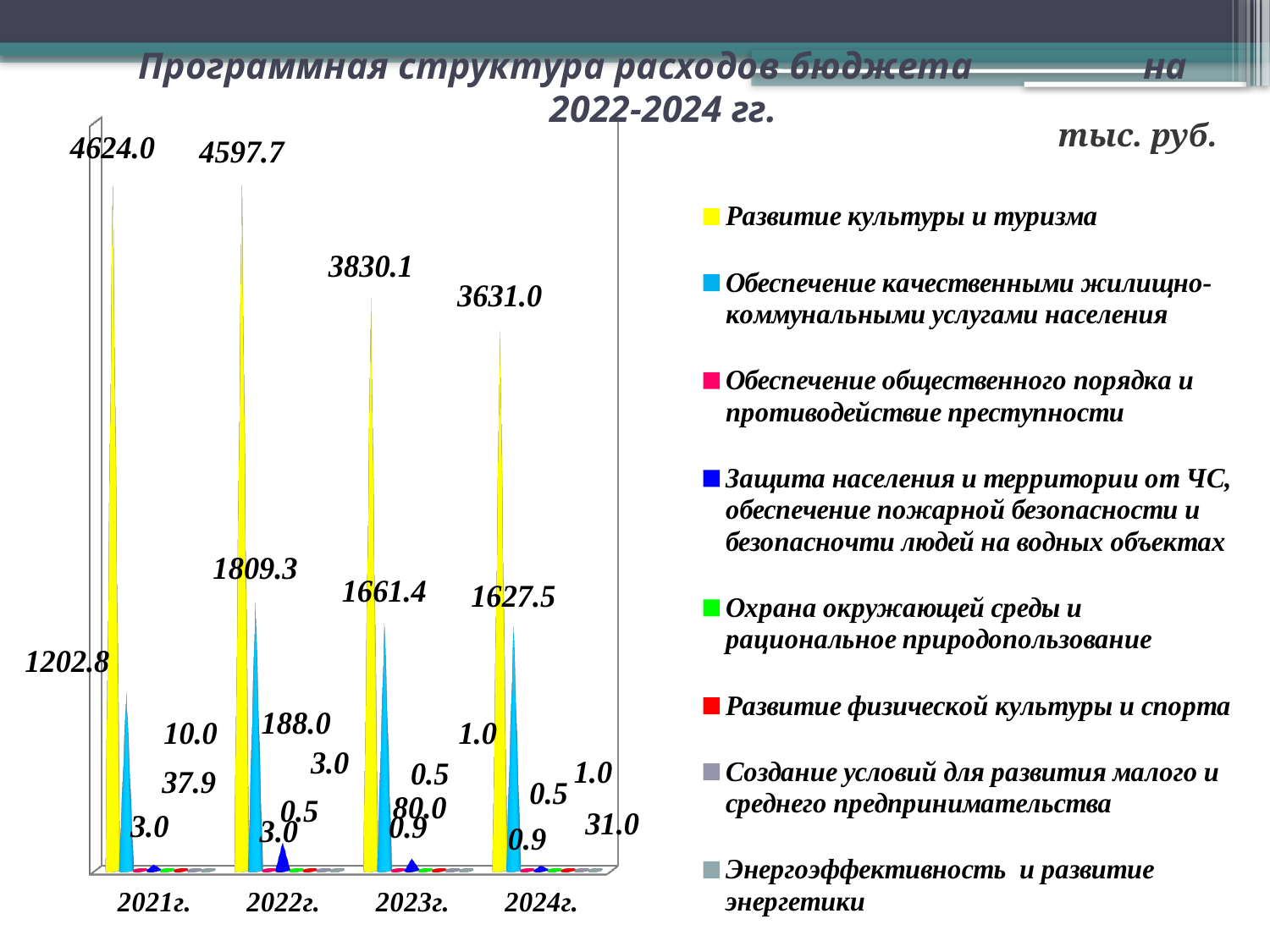
What is the value for Обеспечение качественными жилищно-коммунальными услугами населения in 2023г.? 1661.4 What unit is stated for the chart values? тыс. руб. What is the value for Обеспечение качественными жилищно-коммунальными услугами населения in 2022г.? 1809.3 What is the value for Развитие культуры и туризма in 2024г.? 3631.0 In which year is the value for Обеспечение качественными жилищно-коммунальными услугами населения the lowest? 2021г. How many years are shown on the x axis? 4 How many series does the legend list? 8 In which year is the value for Развитие культуры и туризма the highest? 2021г. What is the difference between the Развитие культуры и туризма values for 2021г. and 2024г.? 993.0 What is the value for Развитие культуры и туризма in 2021г.? 4624.0 Do the values for Развитие культуры и туризма rise or fall from 2021г. to 2024г.? fall Which is larger in 2023г.: Развитие культуры и туризма or Обеспечение качественными жилищно-коммунальными услугами населения? Развитие культуры и туризма